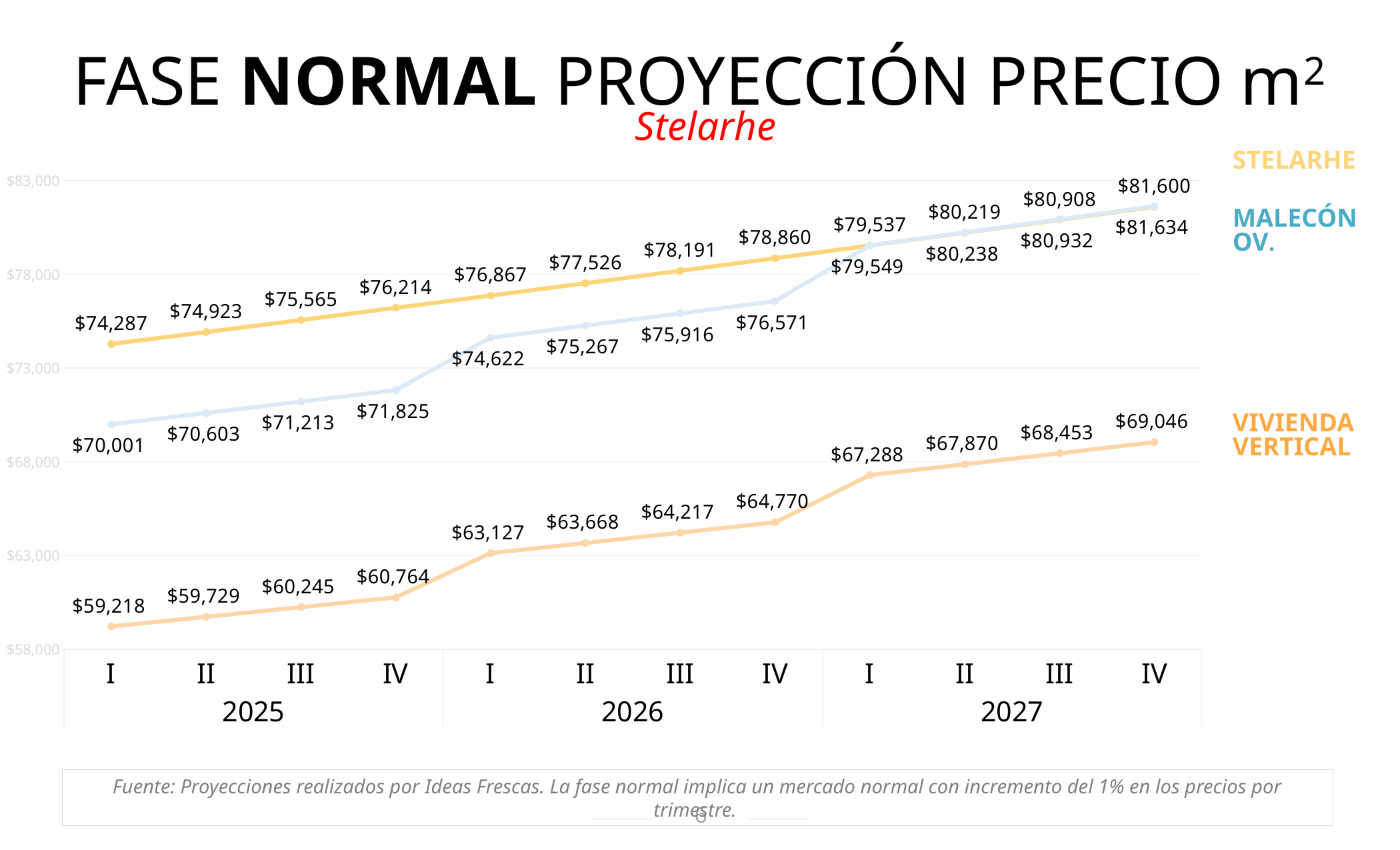
How many series does the chart show? 3 How many quarterly points are plotted along the x axis? 12 What kind of chart is shown on the slide? line chart In which quarter does VIVIENDA VERTICAL reach its highest value? IV 2027 What colour is the STELARHE line? yellow What is the difference between the STELARHE value in quarter IV of 2027 and in quarter I of 2025? $7,313 What is the projected price for MALECÓN OV. in quarter I of 2026? $74,622 In quarter I of 2025, which is higher: STELARHE or VIVIENDA VERTICAL? STELARHE Does the MALECÓN OV. series rise or fall from 2025 to 2027? rise What is the projected price for STELARHE in quarter I of 2025? $74,287 In which quarter is the STELARHE value lowest? I 2025 What is the projected price for VIVIENDA VERTICAL in quarter IV of 2027? $69,046